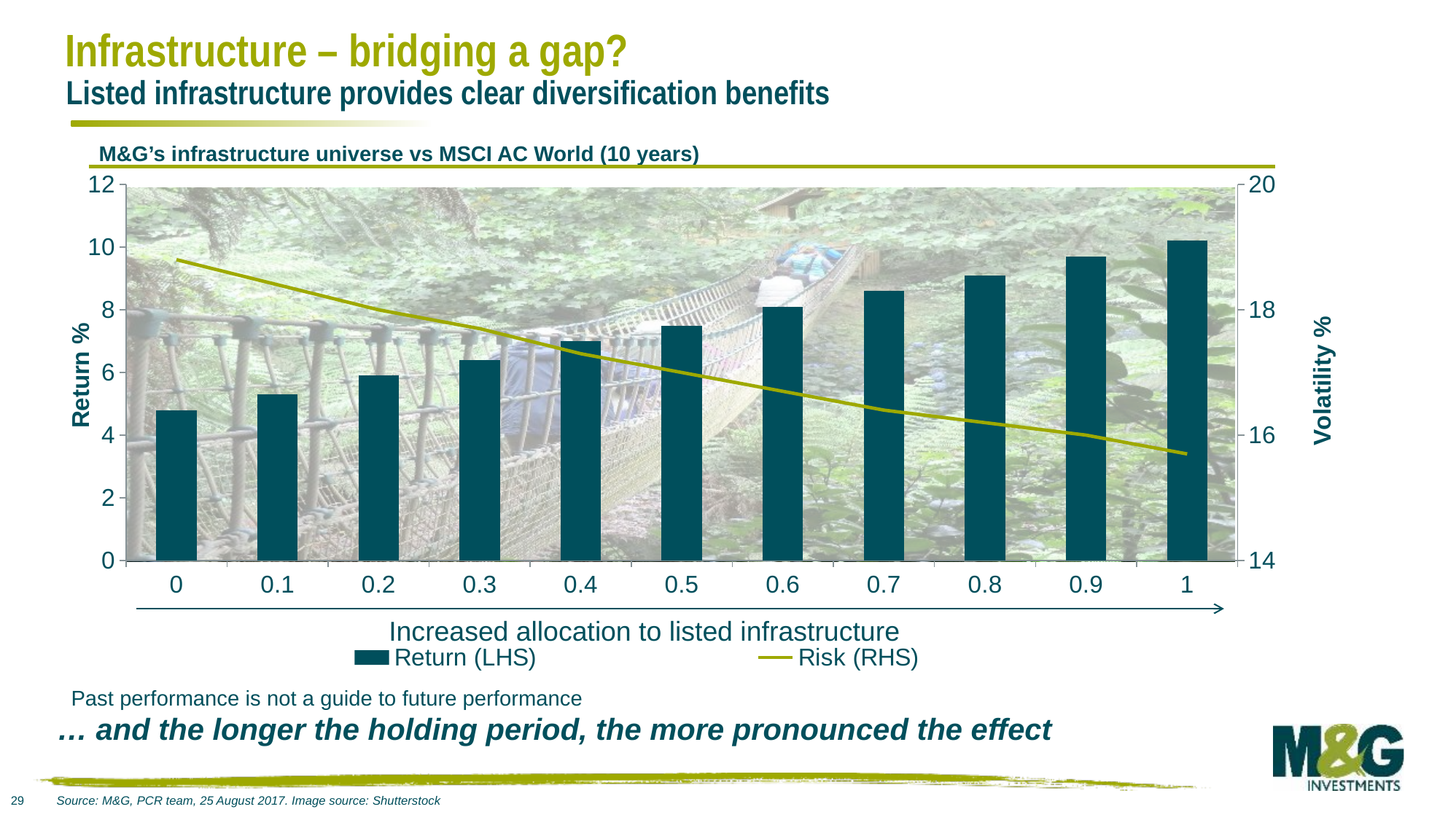
At which allocation level is the Return (LHS) bar highest? 1 Does the Risk (RHS) line rise or fall as the allocation to listed infrastructure increases? Fall Is the Return (LHS) value at allocation 0.8 greater or less than 8? greater What kind of chart is shown on the slide? A combined bar and line chart At which allocation level is the Return (LHS) bar lowest? 0 How many allocation categories are plotted along the x axis? 11 Do the Return (LHS) bars rise or fall as the allocation to listed infrastructure increases? Rise Is the Return (LHS) value at allocation 0.5 greater or less than 8? less Is the Risk (RHS) value at allocation 0 greater or less than 18? greater Which is larger, the Return (LHS) bar at allocation 0.3 or at allocation 0.7? 0.7 How many series does the chart legend list? 2 What is the title of the chart? M&G's infrastructure universe vs MSCI AC World (10 years)